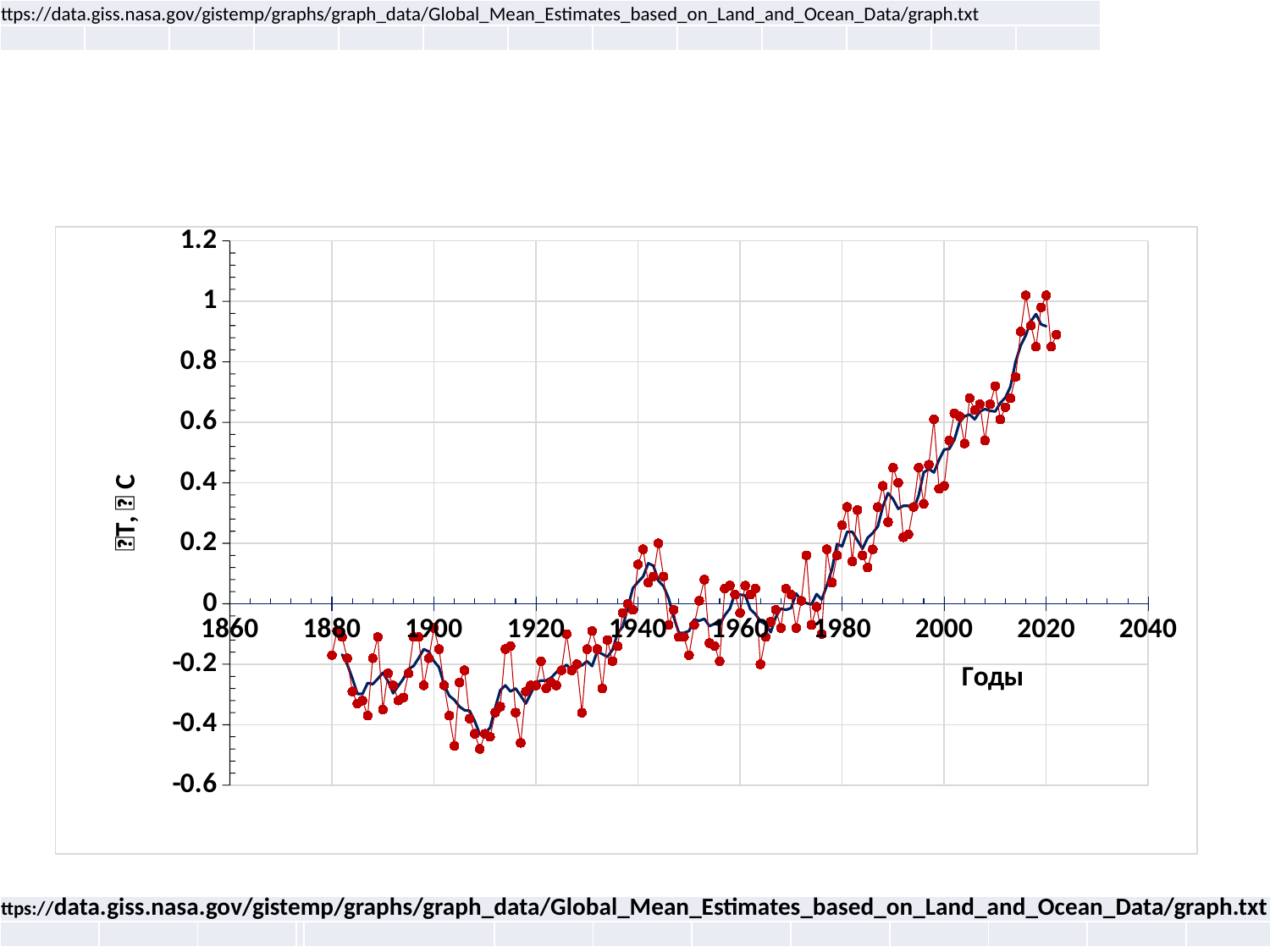
What kind of chart is shown on the slide? line chart What is the title of the x axis? Годы Which period has higher values, the 2010s or the 1880s? the 2010s Is the value for 2016 greater or less than 0.8? greater Is the value for 1960 greater or less than 0.4? less Is the value for 1920 greater or less than 0? less Which period has lower values, the 1900s–1910s or the 1990s? the 1900s–1910s What is the lowest tick value shown on the y axis? -0.6 Overall, do the plotted values rise or fall from 1880 to 2020? rise